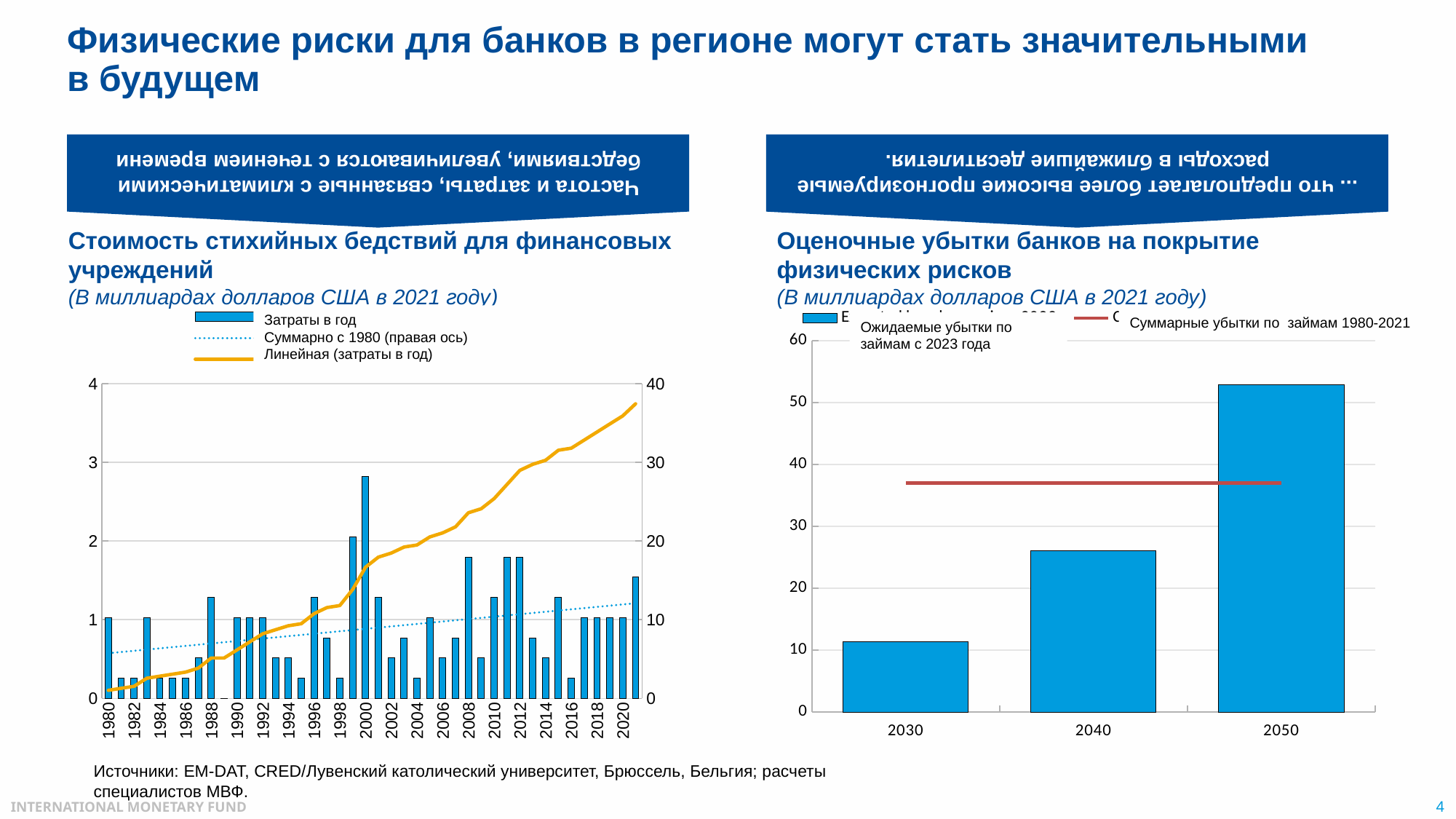
On the right chart (Оценочные убытки банков на покрытие физических рисков), is the value for 2030 greater or less than 20? less On the right chart (Оценочные убытки банков на покрытие физических рисков), do the bar values rise or fall from 2030 to 2050? rise What kind of chart is the right chart (Оценочные убытки банков на покрытие физических рисков)? bar chart On the left chart (Стоимость стихийных бедствий для финансовых учреждений), which year has the highest annual cost bar? 2000 On the right chart (Оценочные убытки банков на покрытие физических рисков), is the red line for cumulative loan losses 1980-2021 greater or less than 40? less On the right chart (Оценочные убытки банков на покрытие физических рисков), how many years are shown on the x axis? 3 On the right chart (Оценочные убытки банков на покрытие физических рисков), is the value for 2050 greater or less than 50? greater How many entries does the legend of the left chart (Стоимость стихийных бедствий для финансовых учреждений) list? 3 On the right chart (Оценочные убытки банков на покрытие физических рисков), which year has the lowest bar? 2030 On the right chart (Оценочные убытки банков на покрытие физических рисков), which year has the highest bar? 2050